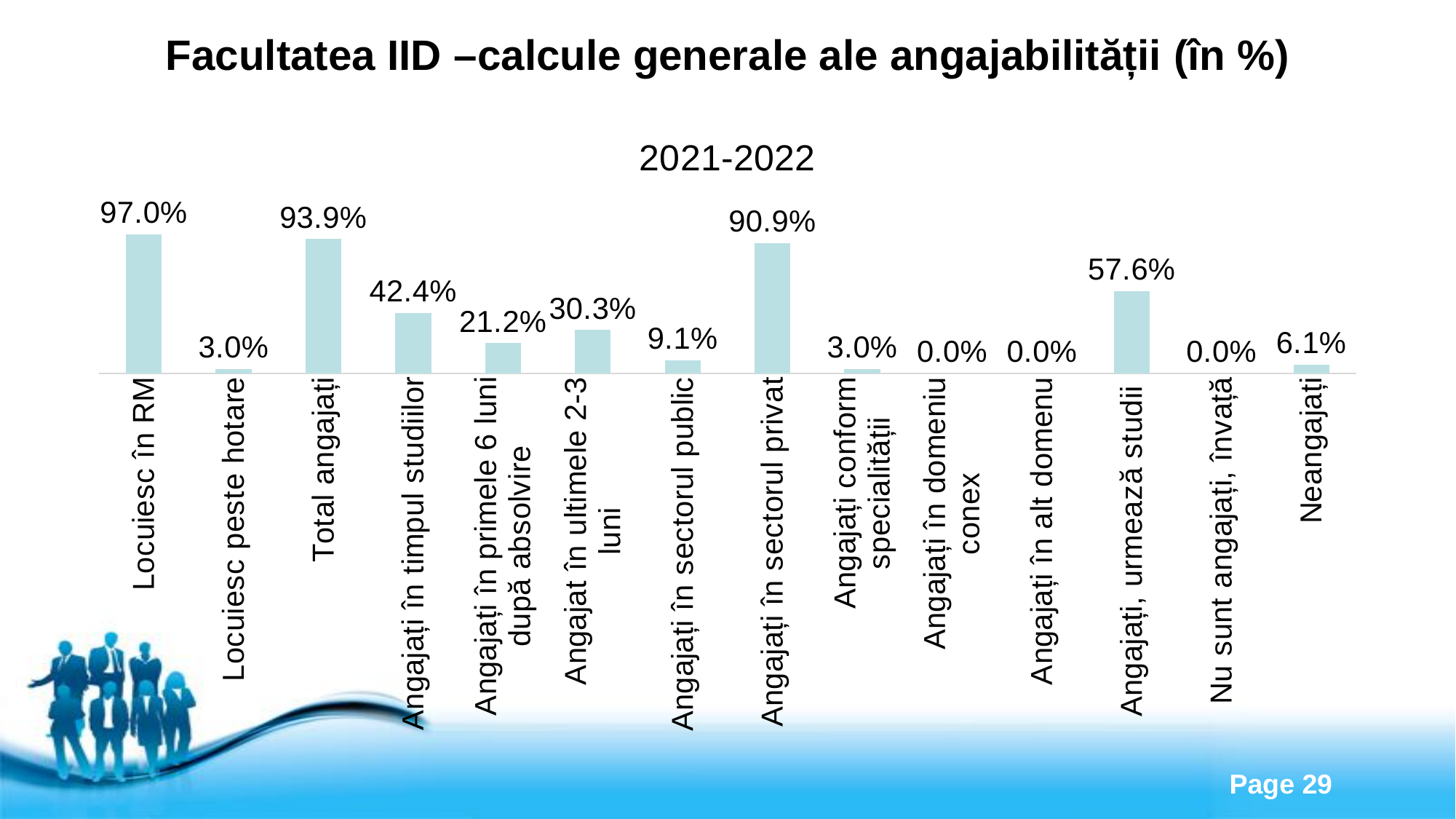
What is the value for Neangajați? 6.1% What is the value for Locuiesc în RM? 97.0% What is the value for Angajați în primele 6 luni după absolvire? 21.2% What is the difference between Angajați în sectorul privat and Angajați în sectorul public? 81.8% What is the difference between Total angajați and Angajați în timpul studiilor? 51.5% What kind of chart is shown on the slide? Bar chart What is the value for Angajați în sectorul privat? 90.9% What is the value for Angajați, urmează studii? 57.6% What is the title of the chart? 2021-2022 Which category has the highest value? Locuiesc în RM Which is larger, Angajat în ultimele 2-3 luni or Angajați în primele 6 luni după absolvire? Angajat în ultimele 2-3 luni How many categories are shown in the chart? 14